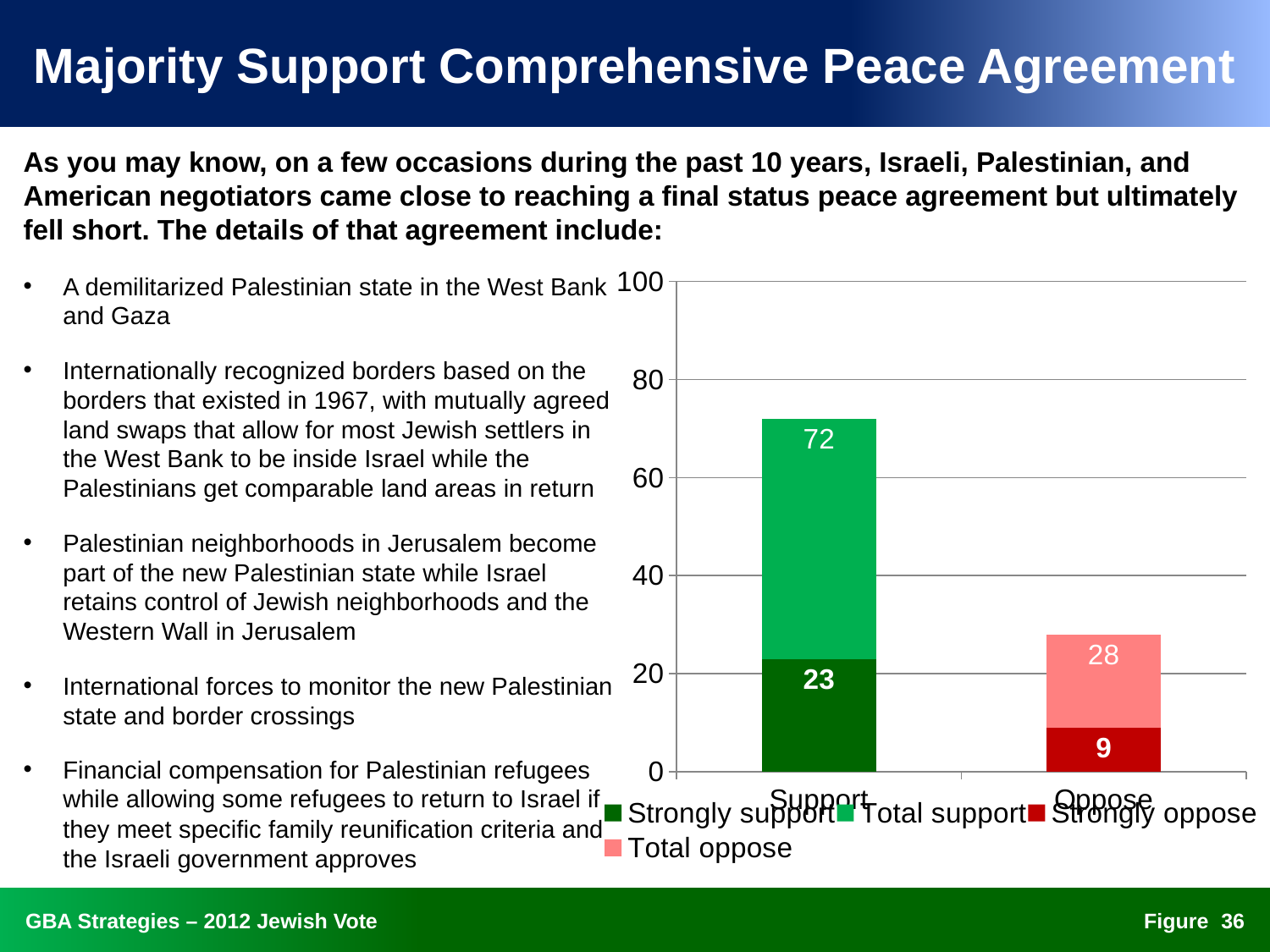
How many categories are shown on the x axis of the chart? 2 What is the Strongly oppose value shown on the Oppose bar? 9 What is the Total oppose value shown on the Oppose bar? 28 What is the Strongly support value shown on the Support bar? 23 What kind of chart is shown on the slide? bar chart What is the difference between the Strongly support value and the Strongly oppose value? 14 Is the top of the Oppose bar greater or less than 40? less Is the top of the Support bar greater or less than 60? greater Which category has the taller bar, Support or Oppose? Support What is the difference between the Total support value and the Total oppose value? 44 What is the Total support value shown on the Support bar? 72 How many series does the chart legend list? 4